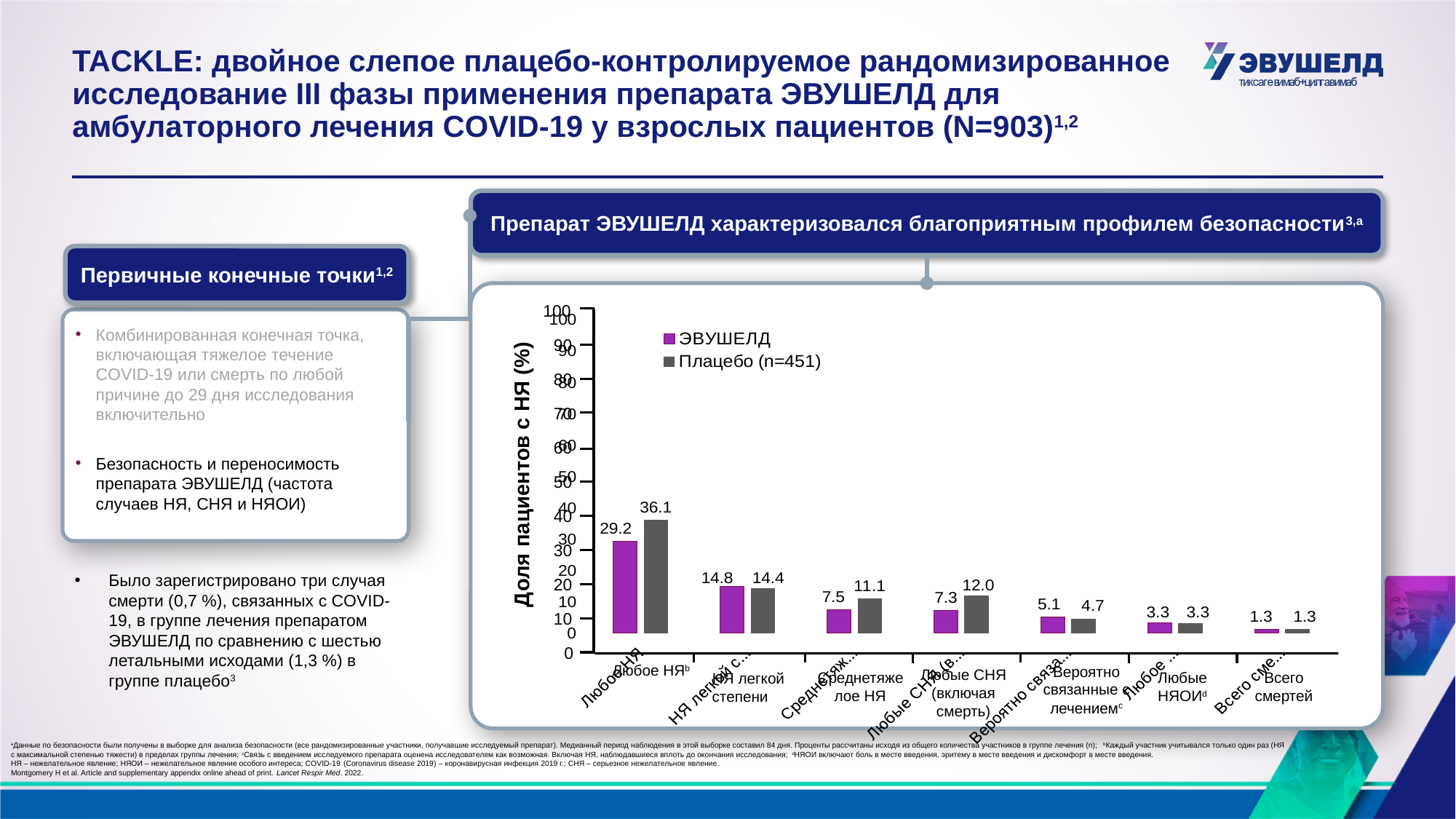
What is the label of the y axis of the chart? Доля пациентов с НЯ (%) Which category has the highest value for the ЭВУШЕЛД series? Любое НЯ In the category Среднетяжелое НЯ, which series has the larger value, ЭВУШЕЛД or Плацебо (n=451)? Плацебо (n=451) How many categories are shown on the x axis of the chart? 7 How many series does the chart legend list? 2 What is the value for Плацебо (n=451) in the category Любые СНЯ (включая смерть)? 12.0 What is the value for Плацебо (n=451) in the category Любое НЯ? 36.1 What is the value for ЭВУШЕЛД in the category Всего смертей? 1.3 What is the value for ЭВУШЕЛД in the category Любое НЯ? 29.2 What is the difference between the Плацебо (n=451) and ЭВУШЕЛД values in the category Любое НЯ? 6.9 Which category has the lowest value for the Плацебо (n=451) series? Всего смертей What type of chart is shown on the slide? bar chart